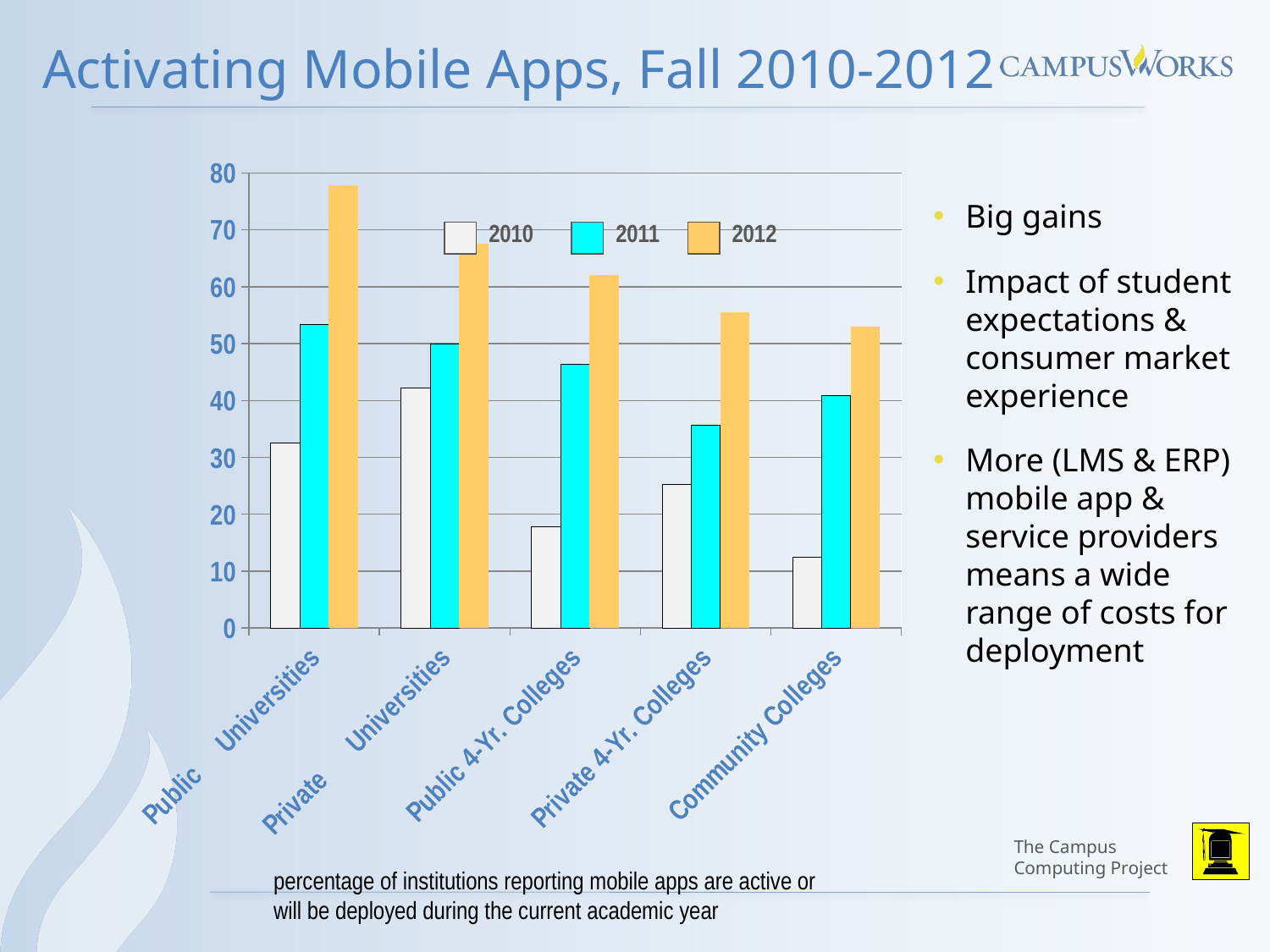
Which is larger for Private 4-Yr. Colleges, the 2011 value or the 2012 value? 2012 Which category has the highest 2012 value? Public Universities What kind of chart is shown on the slide? bar chart How many institution categories are shown on the x axis? 5 Which colour represents the 2011 series in the legend? cyan Is the 2012 value for Public Universities greater or less than 70? greater Is the 2011 value for Community Colleges greater or less than 30? greater Within each category, do the values rise or fall from 2010 to 2012? rise Which is larger, the 2010 value for Private Universities or the 2010 value for Public Universities? Private Universities Which category has the lowest 2010 value? Community Colleges How many series does the legend list? 3 Is the 2010 value for Public 4-Yr. Colleges greater or less than 20? less